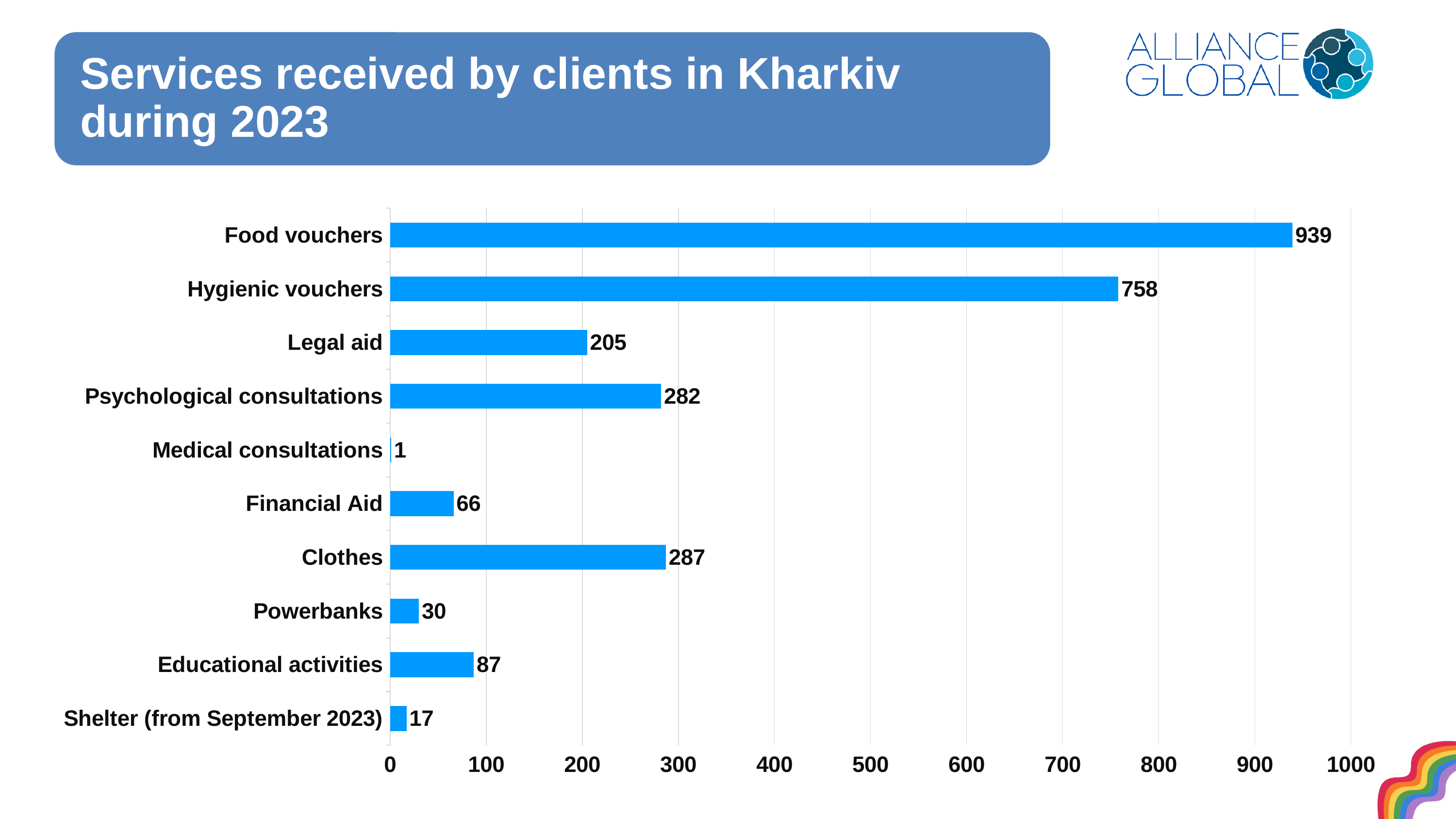
Is the value for Hygienic vouchers greater or less than 700? greater What is the title of the slide? Services received by clients in Kharkiv during 2023 What is the difference between Clothes and Legal aid? 82 Which service has the highest value? Food vouchers What value is shown for Shelter (from September 2023)? 17 How many services are shown in the chart? 10 What is the difference between Food vouchers and Hygienic vouchers? 181 Which service has the lowest value? Medical consultations What value is shown for Food vouchers? 939 Which is larger, Educational activities or Financial Aid? Educational activities What value is shown for Psychological consultations? 282 What kind of chart is shown on the slide? Bar chart